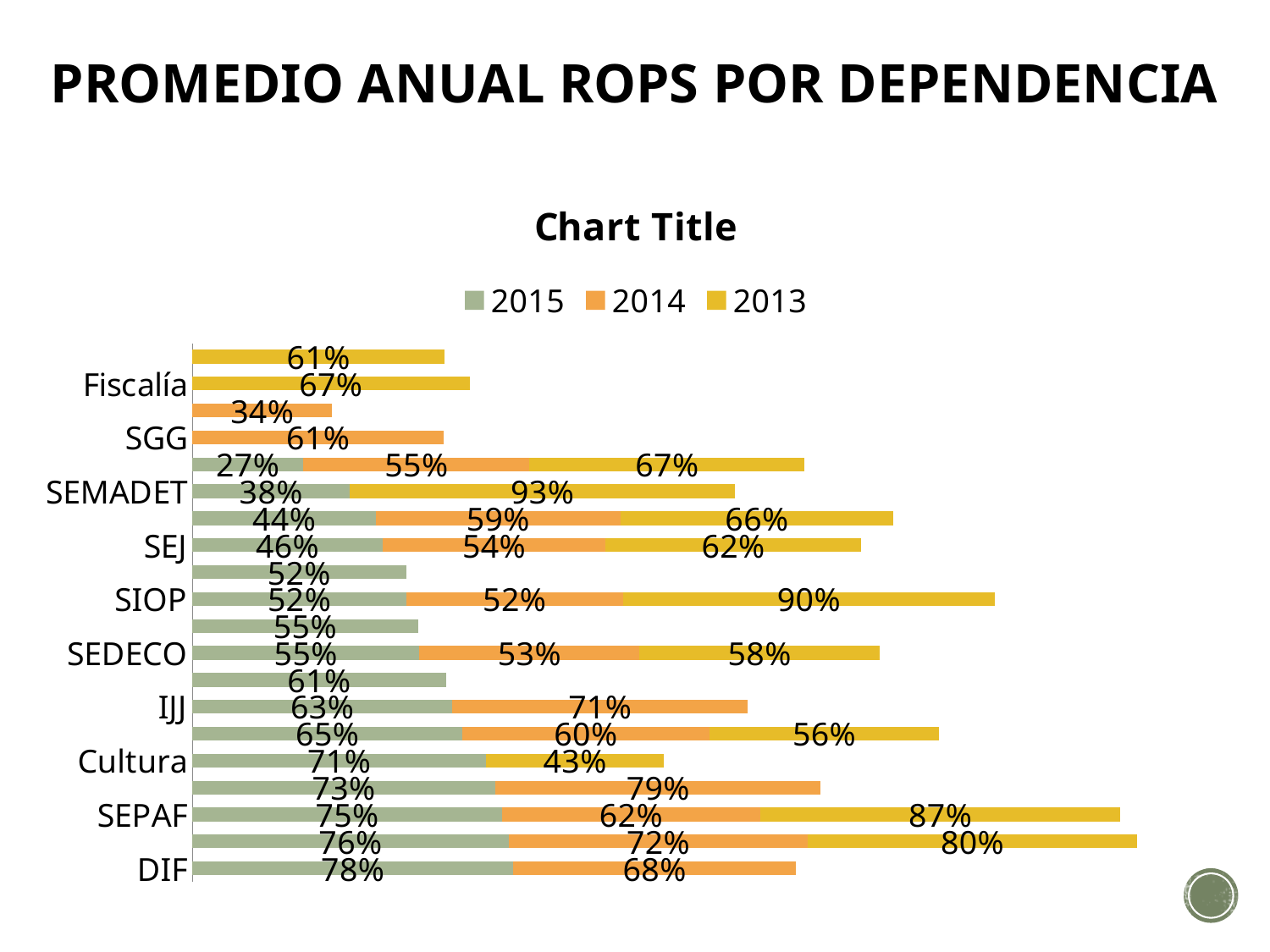
What kind of chart is shown on the slide? Stacked bar chart What is the 2013 value for SIOP? 90% Which years are listed in the legend? 2015, 2014, 2013 How many series does the legend list? 3 Which is larger, the 2013 value for SIOP or the 2013 value for SEDECO? SIOP What is the difference between the 2013 and 2015 values for SEPAF? 12 percentage points How many category labels are shown on the vertical axis? 10 What is the total of the stacked bar for SIOP? 194% What is the 2015 value for DIF? 78% What is the total of the stacked bar for SEPAF? 224% What is the 2014 value for SEPAF? 62% What is the 2013 value for SEMADET? 93%